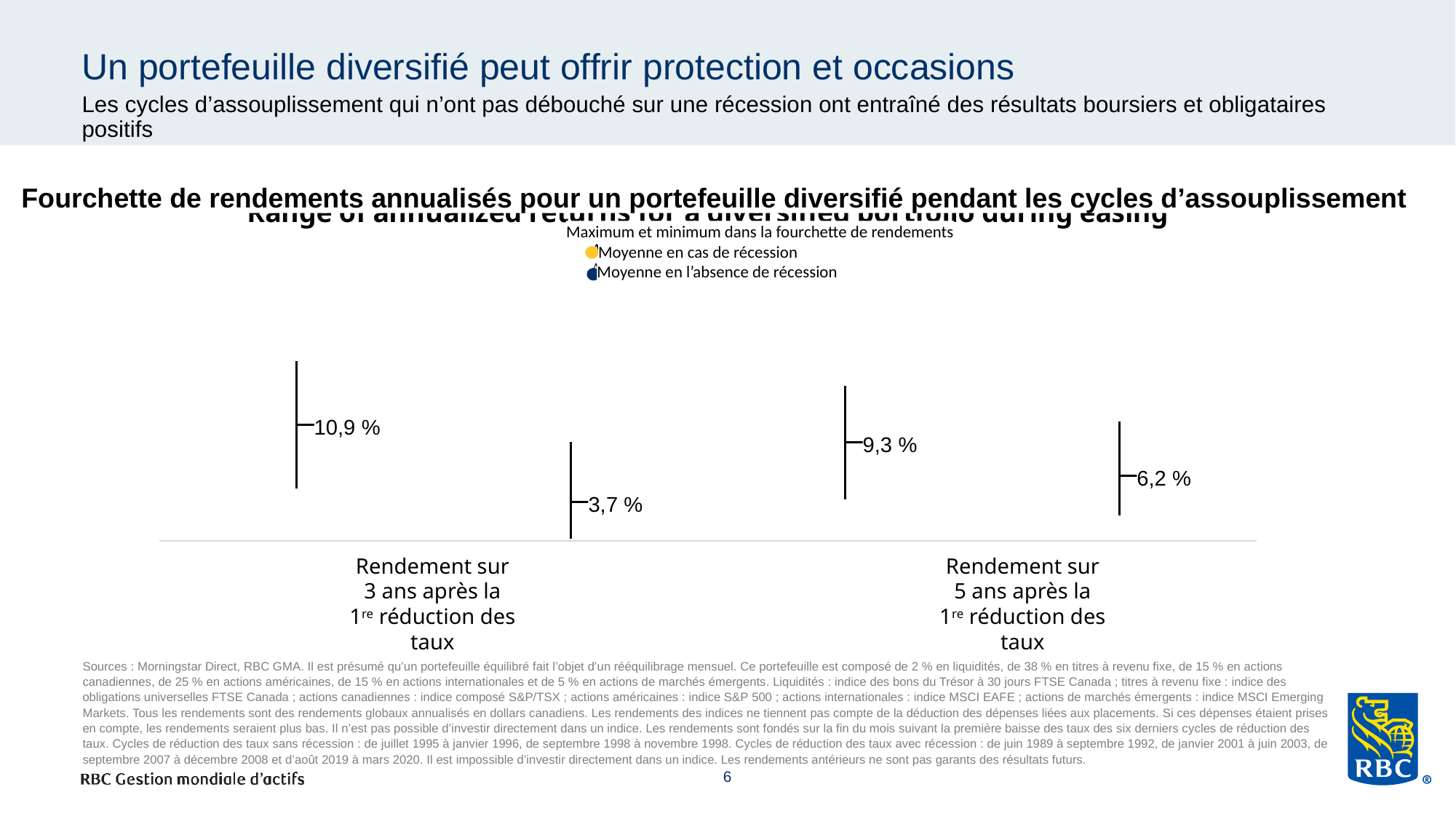
What is the value labelled on the right-hand line in the "Rendement sur 5 ans après la 1re réduction des taux" group? 6,2 % What is the difference between the two labelled values in the "Rendement sur 5 ans après la 1re réduction des taux" group (9,3 % and 6,2 %)? 3,1 % What is the value labelled on the left-hand line in the "Rendement sur 5 ans après la 1re réduction des taux" group? 9,3 % How many entries does the chart legend list? 3 What is the value labelled on the right-hand line in the "Rendement sur 3 ans après la 1re réduction des taux" group? 3,7 % Which is larger: the right-hand labelled value for the 3-year group (3,7 %) or the right-hand labelled value for the 5-year group (6,2 %)? 6,2 % (5-year group) What is the difference between the two labelled values in the "Rendement sur 3 ans après la 1re réduction des taux" group (10,9 % and 3,7 %)? 7,2 % Which labelled value on the chart is the highest? 10,9 % What is the value labelled on the left-hand line in the "Rendement sur 3 ans après la 1re réduction des taux" group? 10,9 % How many categories are shown along the x axis of the chart? 2 Which legend entry is marked with a yellow dot? Moyenne en cas de récession Which labelled value on the chart is the lowest? 3,7 %